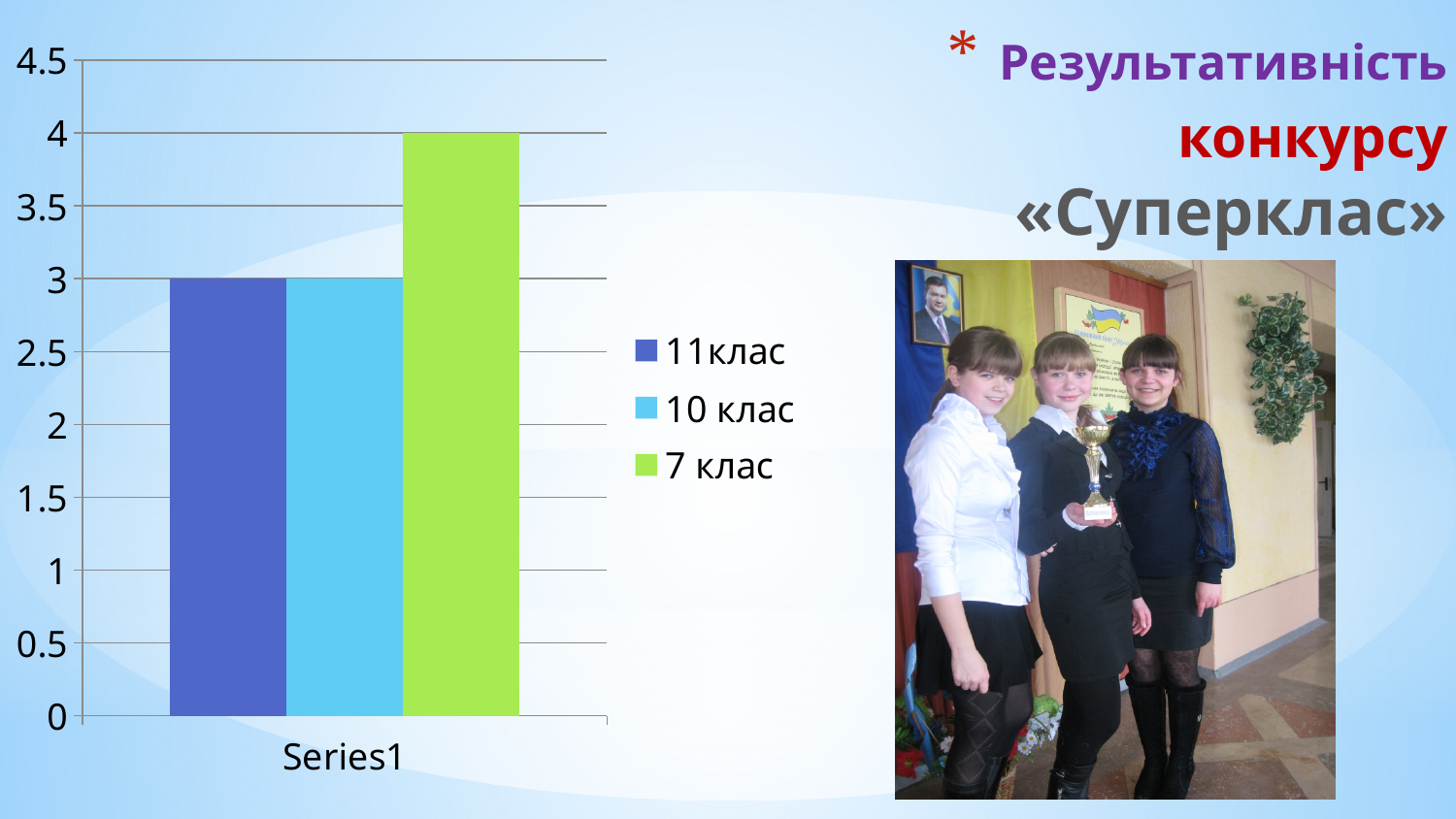
How many series does the chart legend list? 3 What is the value for 11клас? 3 What is the value for 10 клас? 3 Which series has the highest value? 7 клас Which is larger, the value for 7 клас or the value for 10 клас? 7 клас What is the difference between the values for 7 клас and 11клас? 1 What is the value for 7 клас? 4 Is the value for 11клас greater or less than 3.5? less What label appears on the horizontal axis of the chart? Series1 What colour is the bar for 7 клас? green Is the value for 7 клас greater or less than 3.5? greater What kind of chart is shown on the slide? bar chart